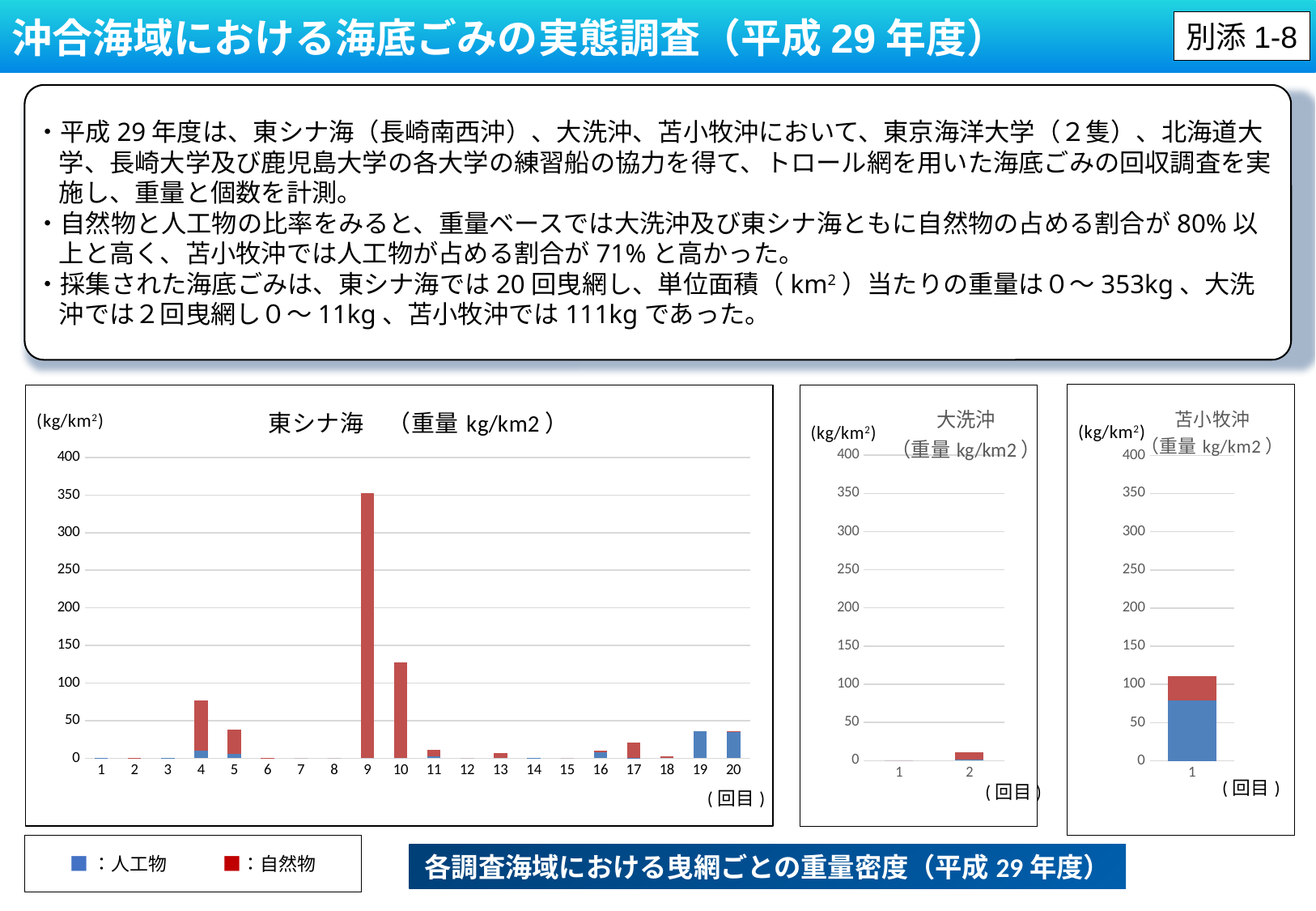
In the 大洗沖 chart, how many tows (回目) are shown on the x axis? 2 In the 東シナ海 chart, is the value for tow 10 greater or less than 100? greater Which colour represents 人工物 in the legend? blue In the 東シナ海 chart, which tow has the highest total weight density? 9 In the 東シナ海 chart, is the value for tow 19 greater or less than 50? less How many series does the legend at the bottom left list? 2 In the 大洗沖 chart, is the value for tow 2 greater or less than 50? less What kind of chart is the 東シナ海 chart? bar chart In the 苫小牧沖 chart, how many tows (回目) are shown on the x axis? 1 In the 東シナ海 chart, how many tows (回目) are shown on the x axis? 20 In the 東シナ海 chart, which is larger, the value for tow 4 or tow 5? tow 4